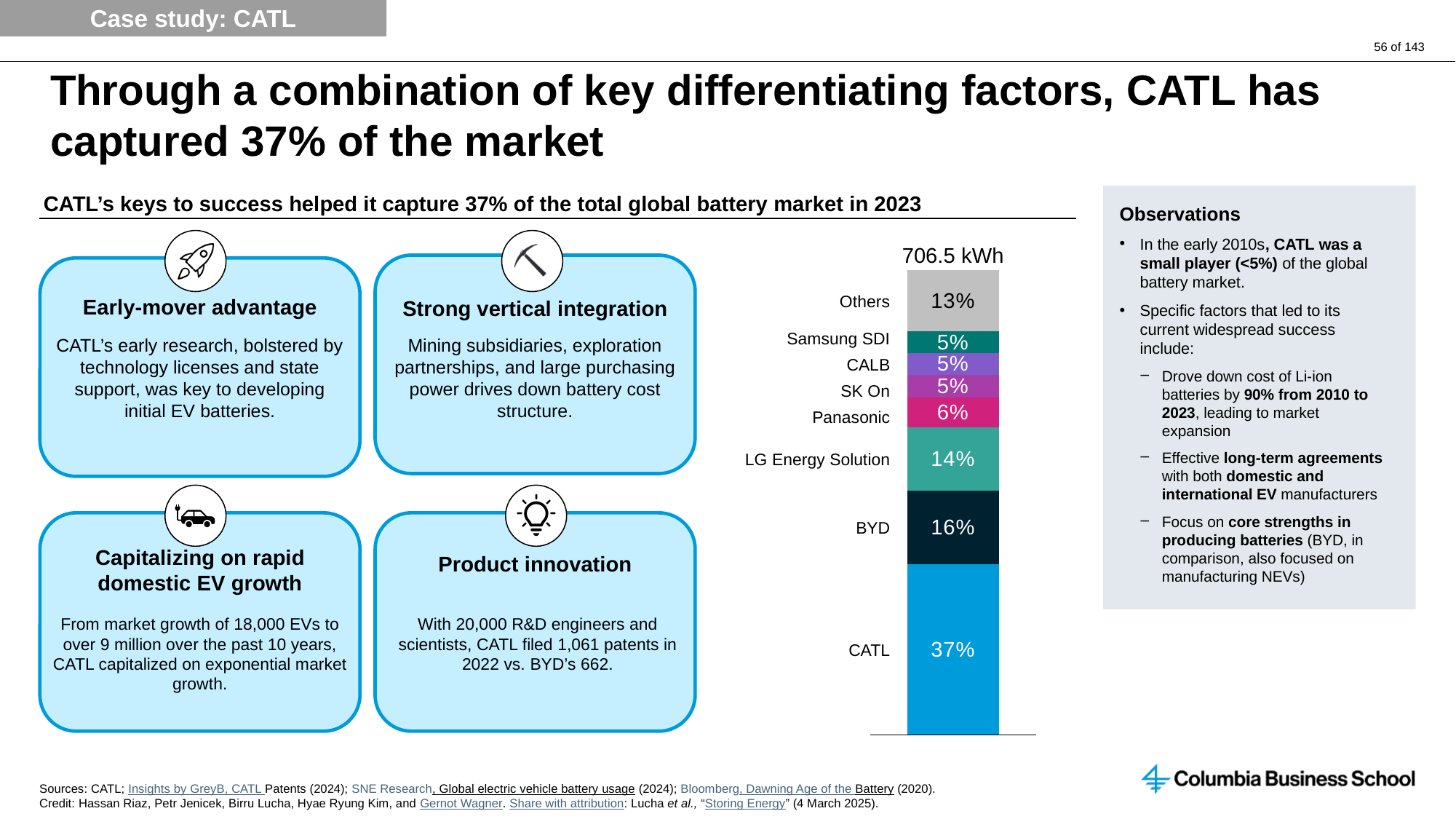
What is the value shown for Panasonic in the stacked bar chart? 6% What is the value shown for BYD in the stacked bar chart? 16% How many named segments (including Others) make up the stacked bar? 8 What share of the global battery market does CATL hold in the stacked bar chart? 37% Which company has the largest segment in the stacked bar chart? CATL Which is larger in the stacked bar chart, the share for LG Energy Solution or the share for Others? LG Energy Solution Which three companies each have a 5% share in the stacked bar chart? Samsung SDI, CALB, SK On What is the difference between CATL's share and BYD's share in the stacked bar chart? 21% What is the value shown for LG Energy Solution in the stacked bar chart? 14% What type of chart is used to show the battery market shares? Stacked bar chart What is the value shown for Others in the stacked bar chart? 13% What total value is printed above the stacked bar? 706.5 kWh